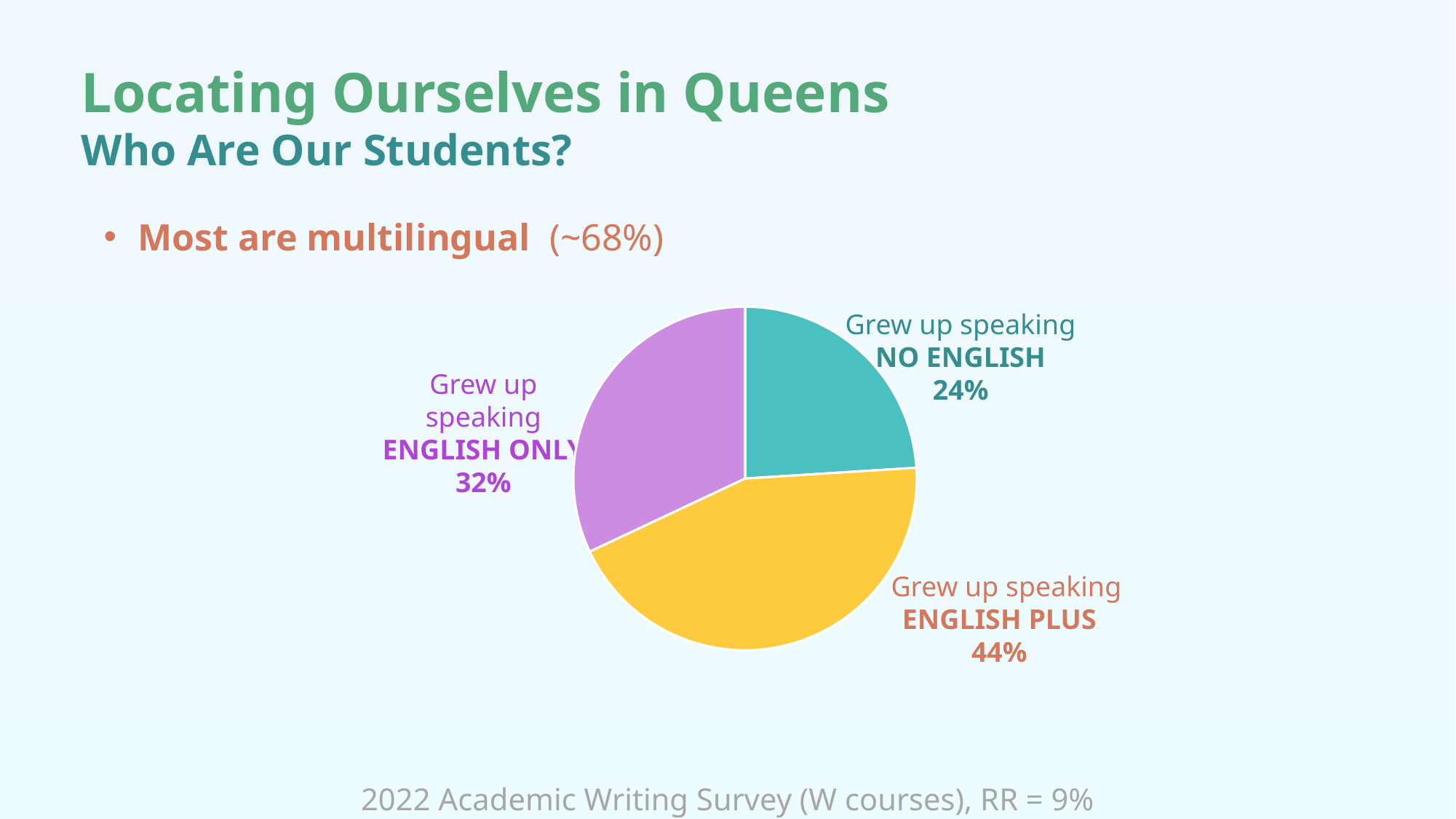
What kind of chart is shown on the slide? pie chart What is the difference in percentage points between the English Plus slice and the English Only slice? 12 Which is larger: the share that grew up speaking English only or the share that grew up speaking no English? Grew up speaking ENGLISH ONLY Which group makes up the smallest slice of the pie? Grew up speaking NO ENGLISH Which group makes up the largest slice of the pie? Grew up speaking ENGLISH PLUS What is the difference in percentage points between the English Only slice and the No English slice? 8 What share of students grew up speaking English plus another language? 44% What share of students grew up speaking no English? 24% What share of students grew up speaking English only? 32% What is the combined share of the No English and English Plus slices? 68% What colour is the slice for students who grew up speaking English only? purple How many slices does the pie chart have? 3